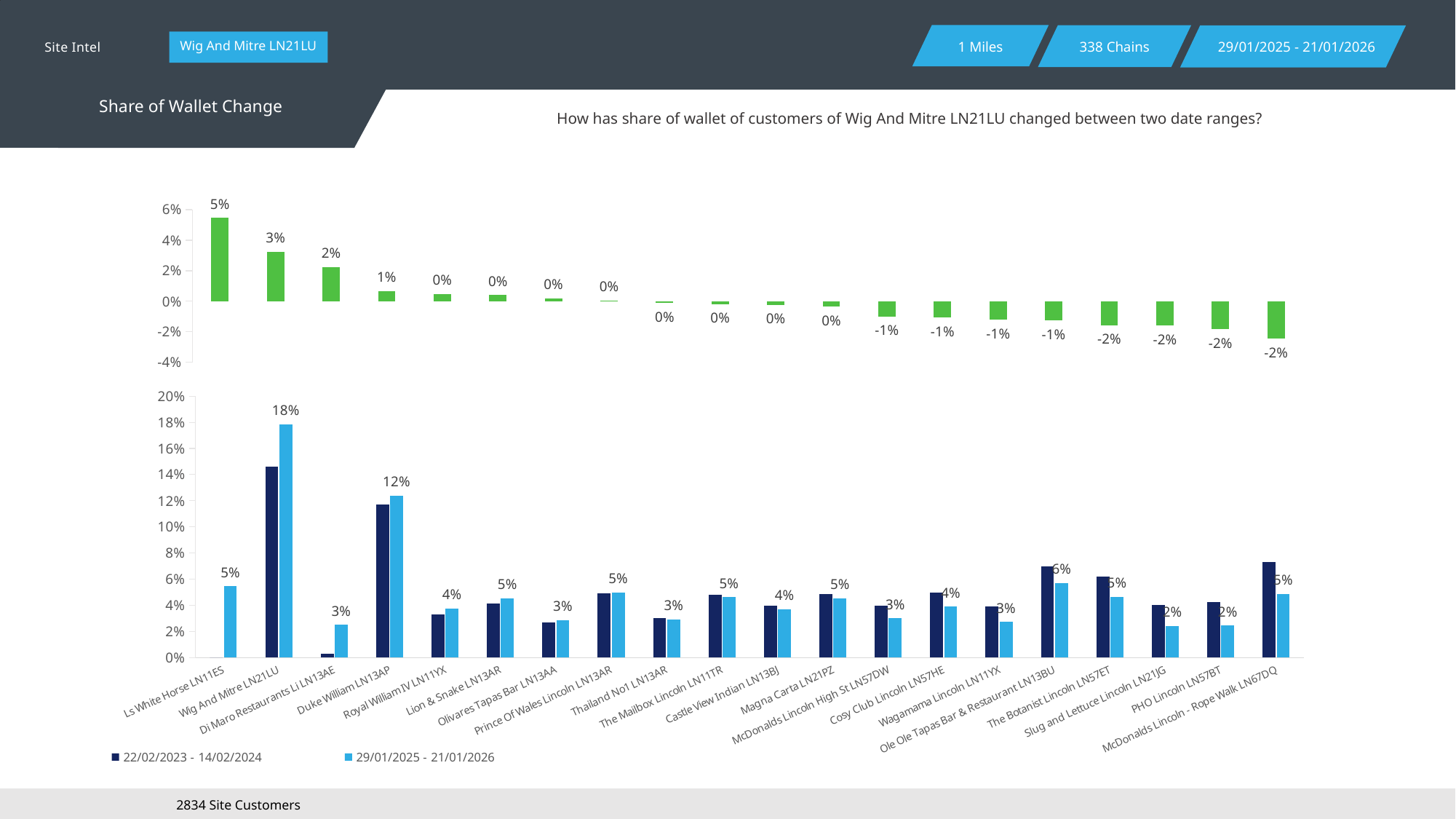
In the bottom chart, what is the value for Duke William LN13AP in the 29/01/2025 - 21/01/2026 series? 12% In the bottom chart, how many series does the legend list? 2 In the bottom chart, what is the difference between Wig And Mitre LN21LU and Duke William LN13AP in the 29/01/2025 - 21/01/2026 series? 6% In the bottom chart, how many categories are shown on the x axis? 20 In the top chart (share of wallet change), what is the value for Ls White Horse LN11ES? 5% In the bottom chart, is the value for Duke William LN13AP in the 22/02/2023 - 14/02/2024 series greater or less than 10%? greater In the top chart (share of wallet change), what is the value for Duke William LN13AP? 1% What kind of chart is the bottom chart? Bar chart In the bottom chart, what is the value for Wig And Mitre LN21LU in the 29/01/2025 - 21/01/2026 series? 18% In the top chart (share of wallet change), what is the value for Ole Ole Tapas Bar & Restaurant LN13BU? -1% In the top chart (share of wallet change), which category has the highest value? Ls White Horse LN11ES